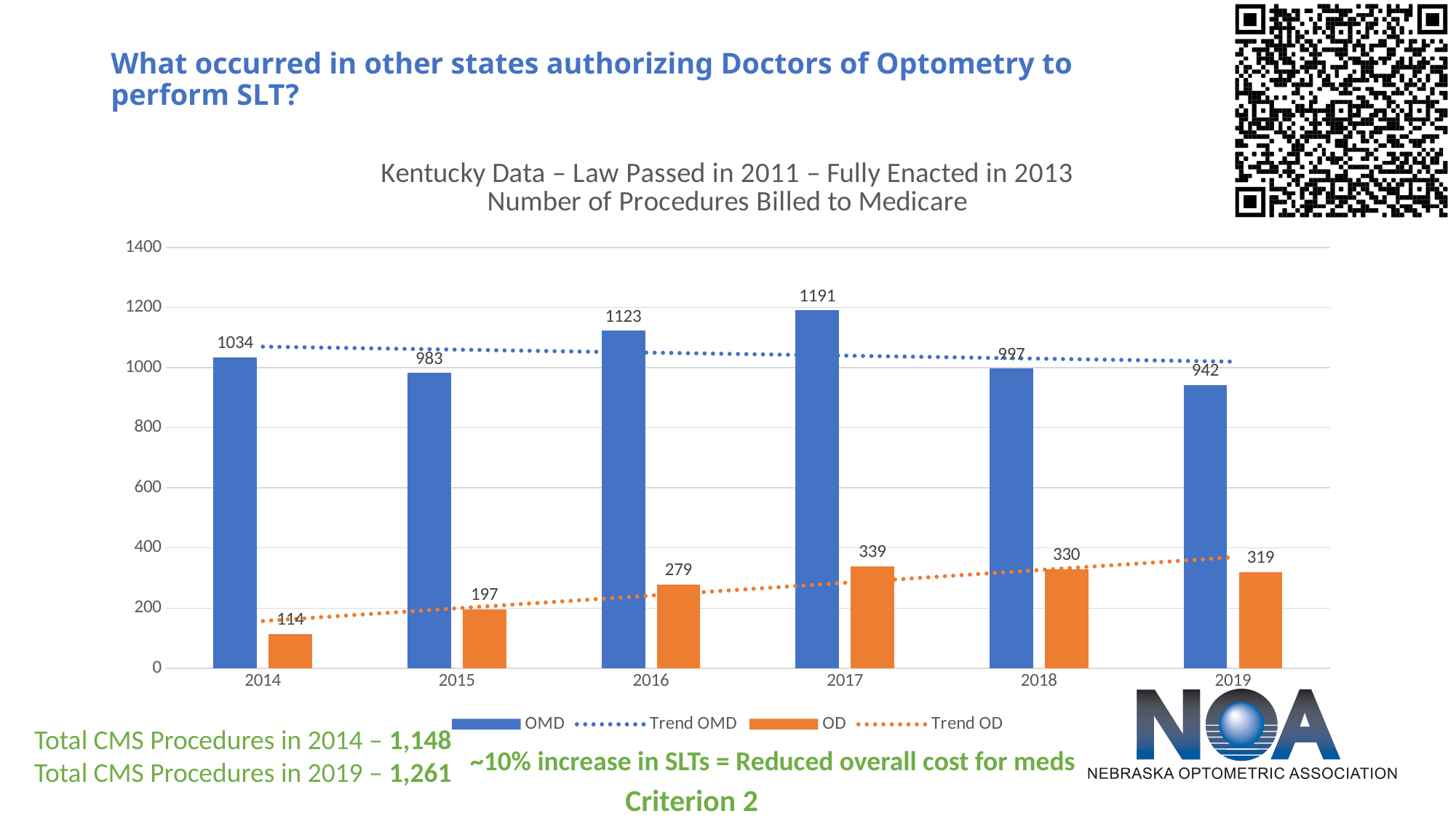
What is the OD value for 2018? 330 How many entries does the legend list? 4 What is the OMD value for 2017? 1191 What kind of chart is shown on the slide? bar chart What is the difference between the OMD and OD values in 2019? 623 Is the OMD value for 2015 greater or less than 1000? less How many years are shown on the x axis? 6 Which year has the lowest OD value? 2014 Which year has the lowest OMD value? 2019 Which is larger, the OD value in 2016 or the OD value in 2019? 2019 What is the OD value for 2014? 114 Which year has the highest OMD value? 2017